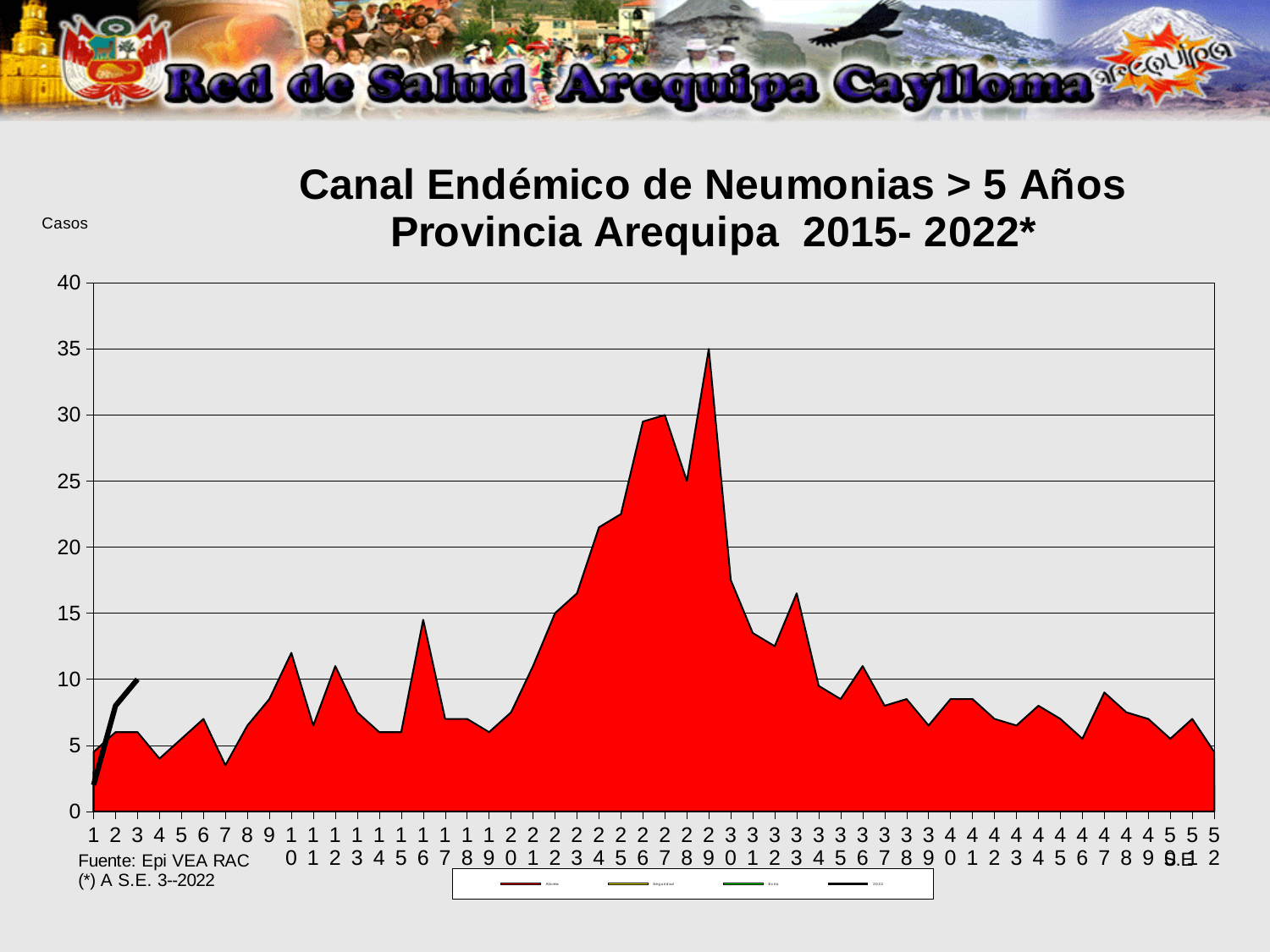
Is the value of the red area at week 29 greater or less than 30? greater Is the value of the red area at week 7 greater or less than 5? less What is the title of the chart? Canal Endémico de Neumonias > 5 Años Provincia Arequipa 2015- 2022* Which has a larger value in the red area, week 29 or week 33? week 29 How many weeks are shown along the x axis of the chart? 52 Is the value of the red area at week 33 greater or less than 15? greater At which week on the x axis does the red area reach its highest value? 29 Which has a larger value in the red area, week 16 or week 10? week 16 What label is shown on the vertical axis of the chart? Casos What kind of chart is shown on the slide? area chart Do the values of the red area rise or fall from week 20 to week 29? rise